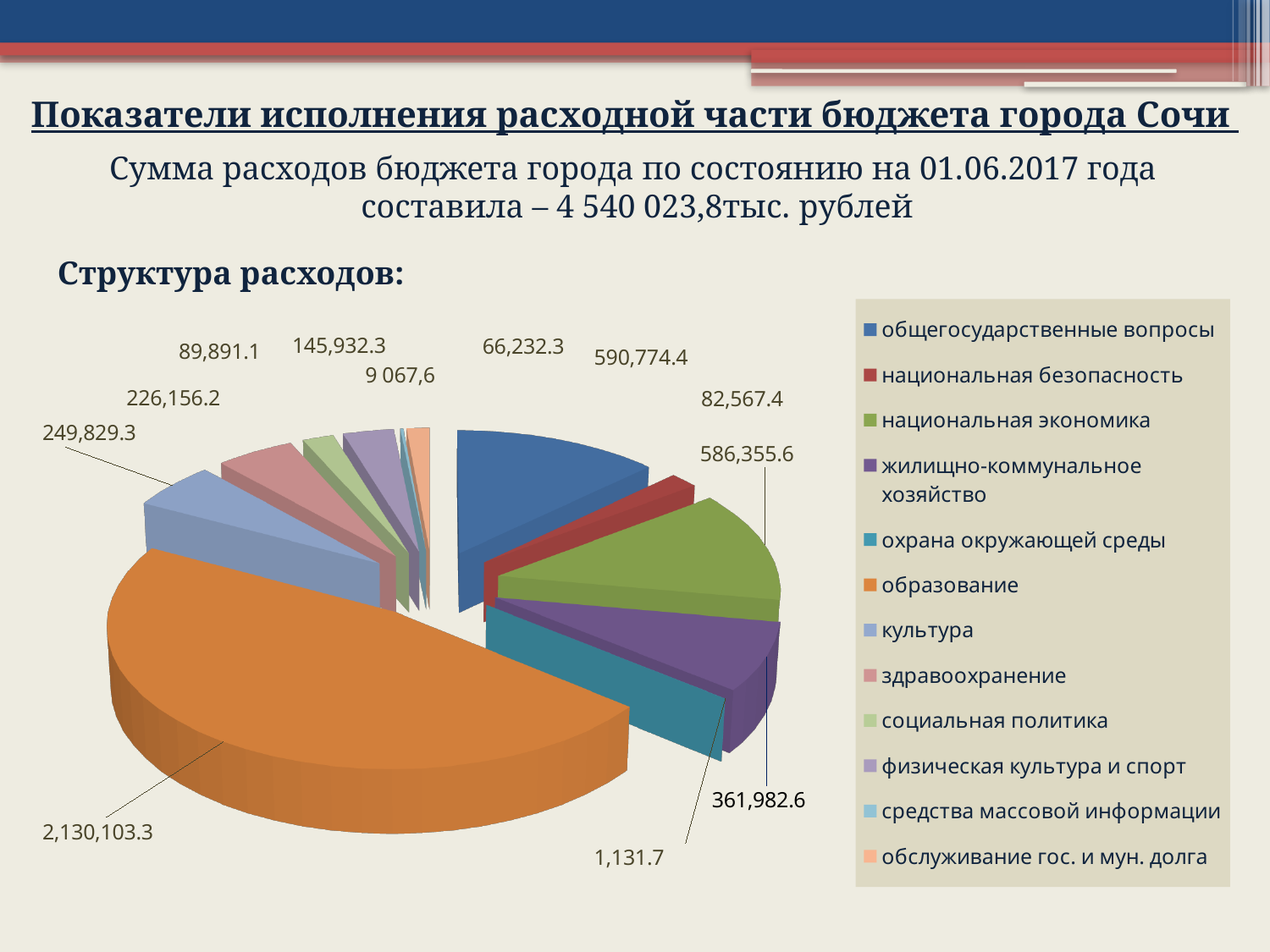
What is the value for культура? 249,829.3 What type of chart is shown on the slide? Pie chart What is the value for общегосударственные вопросы? 590,774.4 What is the value for национальная экономика? 586,355.6 Which category has the largest slice of the pie? образование Which category has the smallest slice of the pie? охрана окружающей среды What is the value for охрана окружающей среды? 1,131.7 What is the value for образование in the pie chart? 2,130,103.3 What is the difference between the values for образование and общегосударственные вопросы? 1,539,328.9 Which is larger, the value for общегосударственные вопросы or the value for национальная экономика? общегосударственные вопросы How many categories does the legend of the pie chart list? 12 What is the value for жилищно-коммунальное хозяйство? 361,982.6